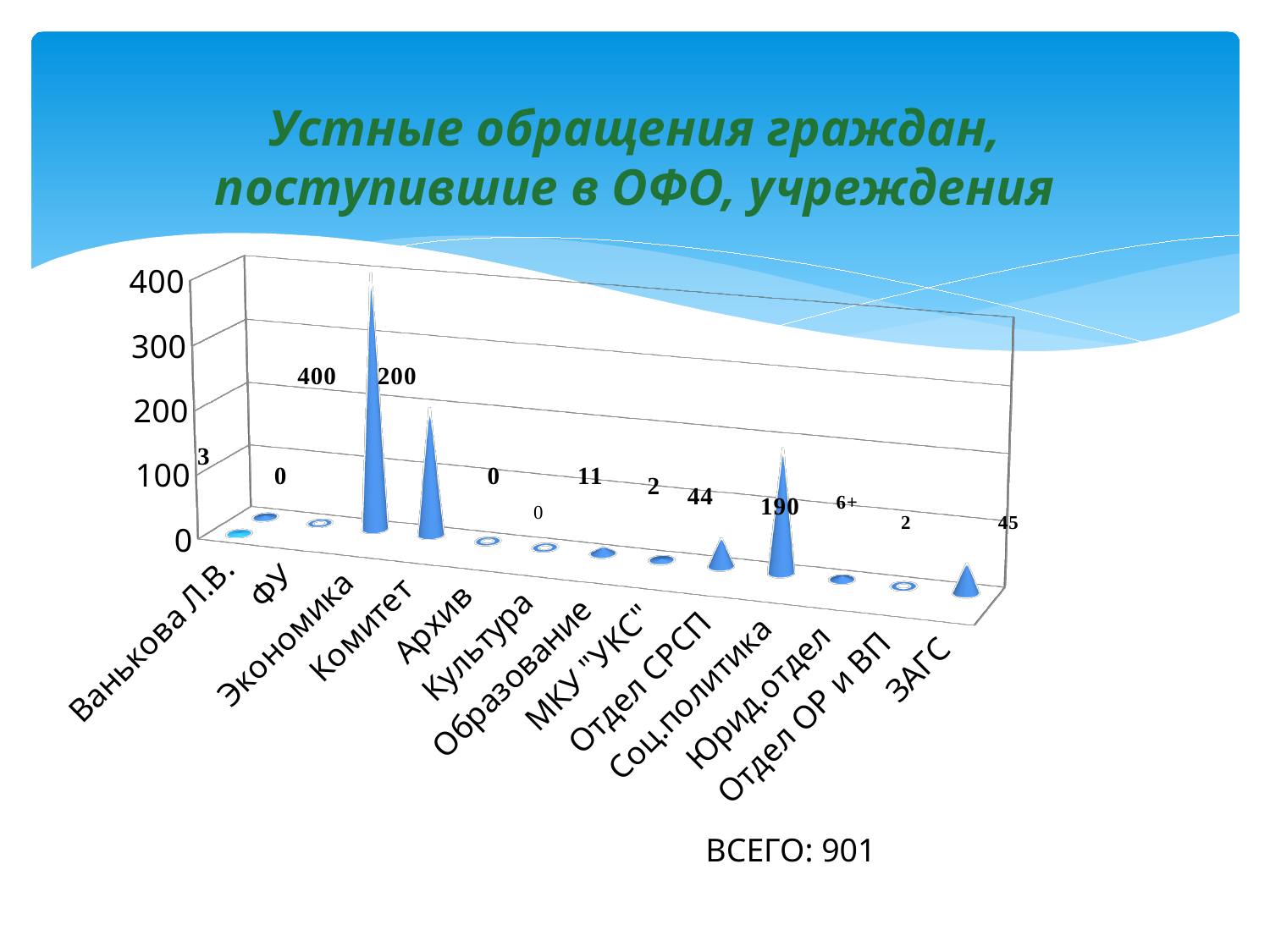
What is the value for Отдел СРСП? 44 What is the value for Комитет? 200 What is the title of the chart on the slide? Устные обращения граждан, поступившие в ОФО, учреждения What is the difference between the values for Экономика and Комитет? 200 What is the value for Соц.политика? 190 What is the value for ЗАГС? 45 What kind of chart is shown on the slide? bar chart Which is larger, the value for Соц.политика or the value for Отдел СРСП? Соц.политика How many categories are shown on the x axis of the chart? 13 Is the value for Экономика greater or less than 300? greater What is the value for Экономика? 400 Which category has the highest value in the chart? Экономика